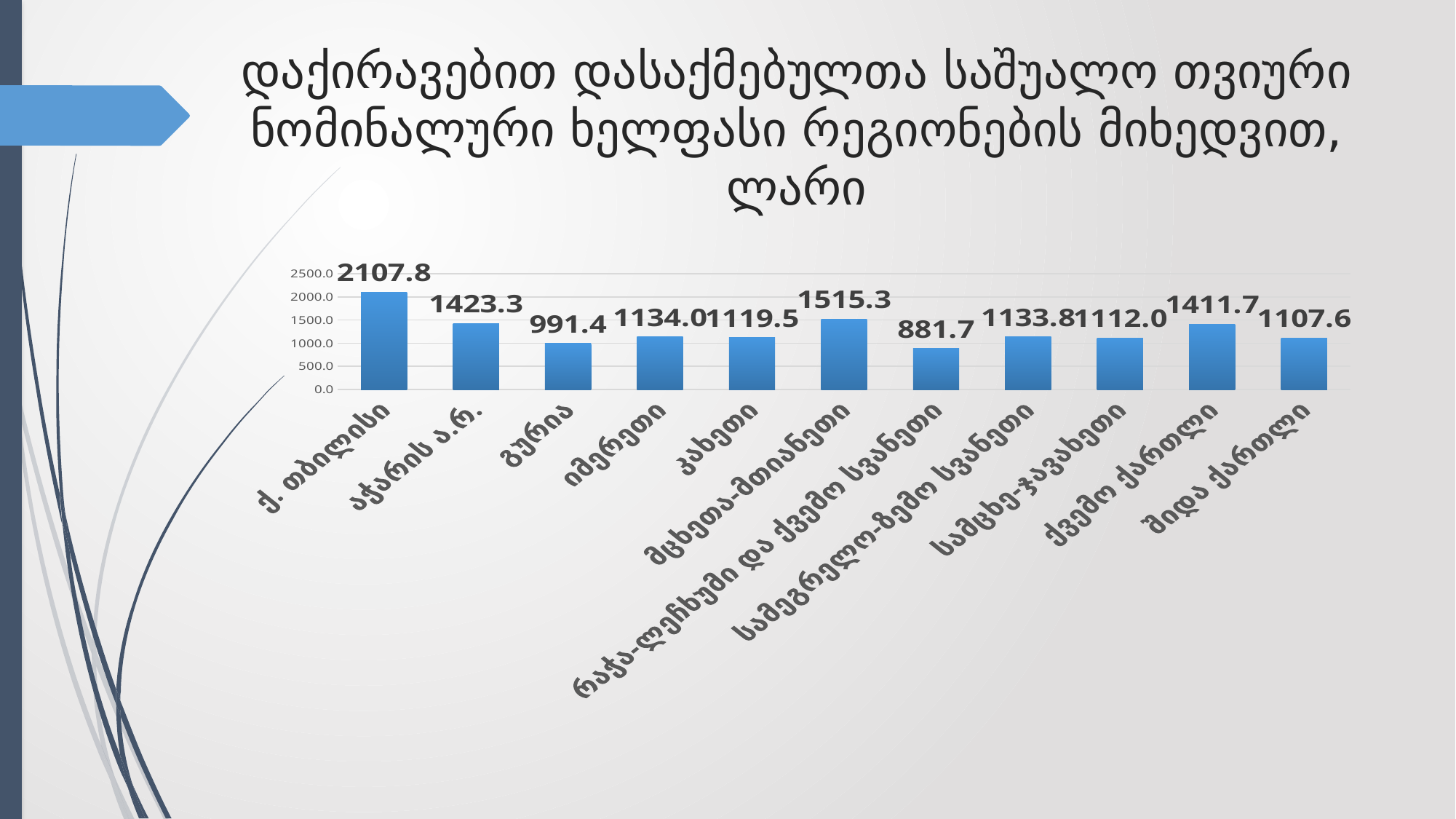
What is the value for მცხეთა-მთიანეთი? 1515.3 What is the difference between the values for ქ. თბილისი and აჭარის ა.რ.? 684.5 What is the value for ქ. თბილისი? 2107.8 What is the value for გურია? 991.4 What is the value for ქვემო ქართლი? 1411.7 Is the value for გურია greater or less than 1000.0? less What kind of chart is shown on the slide? bar chart Which is larger, the value for მცხეთა-მთიანეთი or the value for ქვემო ქართლი? მცხეთა-მთიანეთი What is the highest value shown on the vertical axis? 2500.0 How many regions are shown on the chart? 11 Which region has the lowest value? რაჭა-ლეჩხუმი და ქვემო სვანეთი Which region has the highest value? ქ. თბილისი